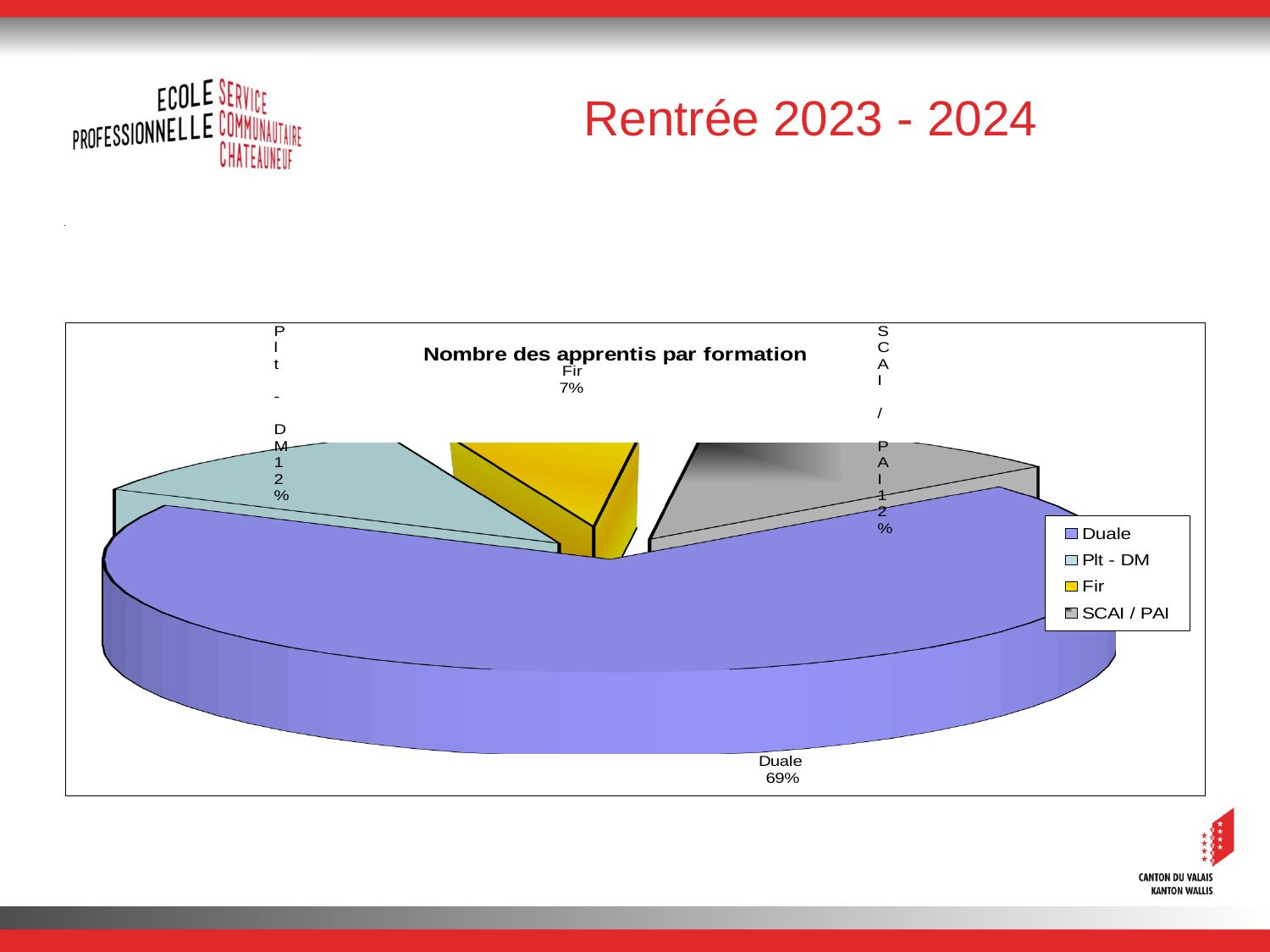
How many entries does the legend list? 4 How many slices does the pie chart have? 4 Which category has the smallest share of the pie? Fir What percentage is shown for Fir? 7% What percentage is shown for Plt - DM? 12% Which is larger, the share for Plt - DM or the share for Fir? Plt - DM What is the title of the chart? Nombre des apprentis par formation What share of the pie does Duale represent? 69% What kind of chart is shown on the slide? Pie chart Which category has the largest share of the pie? Duale What percentage is shown for SCAI / PAI? 12% What is the difference in percentage points between Duale and Fir? 62 percentage points